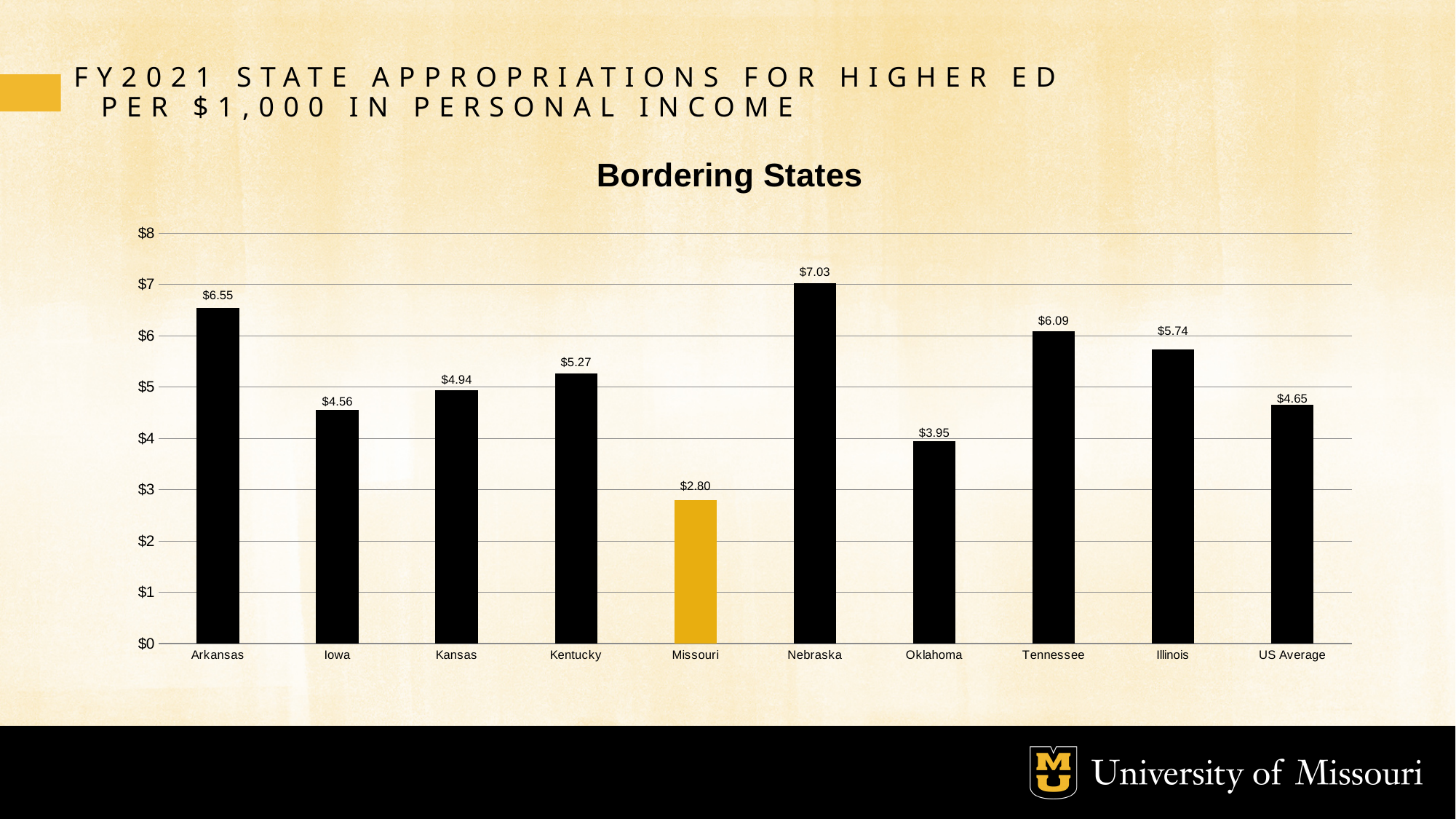
Which category has the highest value? Nebraska What is the value for Nebraska? $7.03 What is the difference between the values for Nebraska and Missouri? $4.23 Is the value for Oklahoma greater or less than $4? less Which is larger, the value for Arkansas or the value for Tennessee? Arkansas Which category has the lowest value? Missouri What is the value for Missouri? $2.80 How many categories are shown on the x axis? 10 What is the value for the US Average? $4.65 Which bar is shown in a different colour (gold) from the others? Missouri What kind of chart is this? bar chart What is the difference between the US Average and Missouri? $1.85